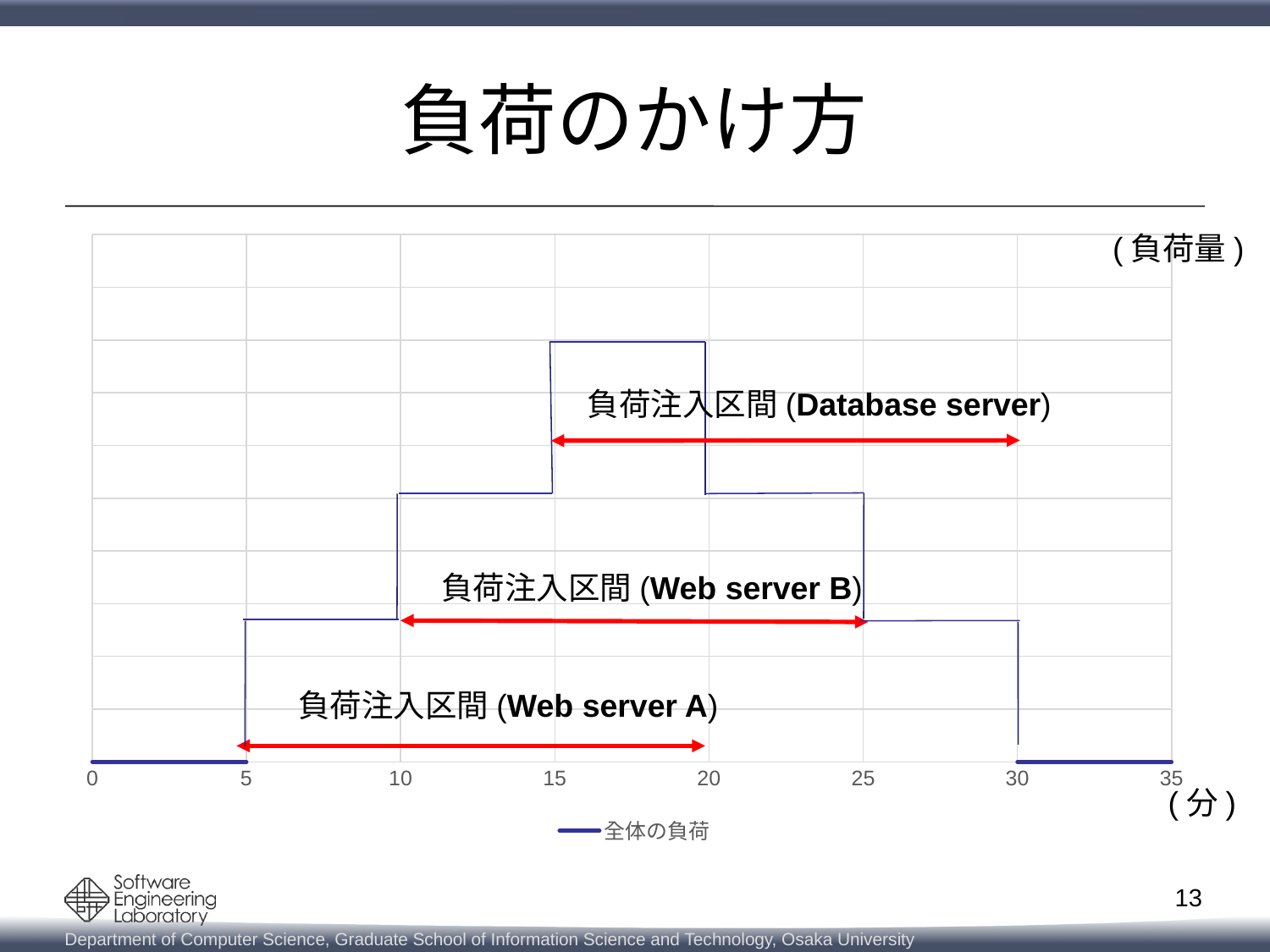
Between x = 0 and x = 15, does the plotted load rise or fall? rise How many load injection intervals (負荷注入区間) are annotated on the chart? 3 Is the plotted load higher at x = 17 or at x = 7? x = 17 Between x = 20 and x = 35, does the plotted load rise or fall? fall What is the largest tick value shown on the x axis of the chart? 35 Which load injection interval (負荷注入区間) starts at x = 15? Database server What is the unit label shown next to the x axis of the chart? (分) In which x-axis interval does the plotted load reach its highest level? 15 to 20 How many series does the chart legend list? 1 What is the name of the series shown in the chart legend? 全体の負荷 How many tick labels are shown on the x axis of the chart? 8 What kind of chart is shown on the slide? line chart